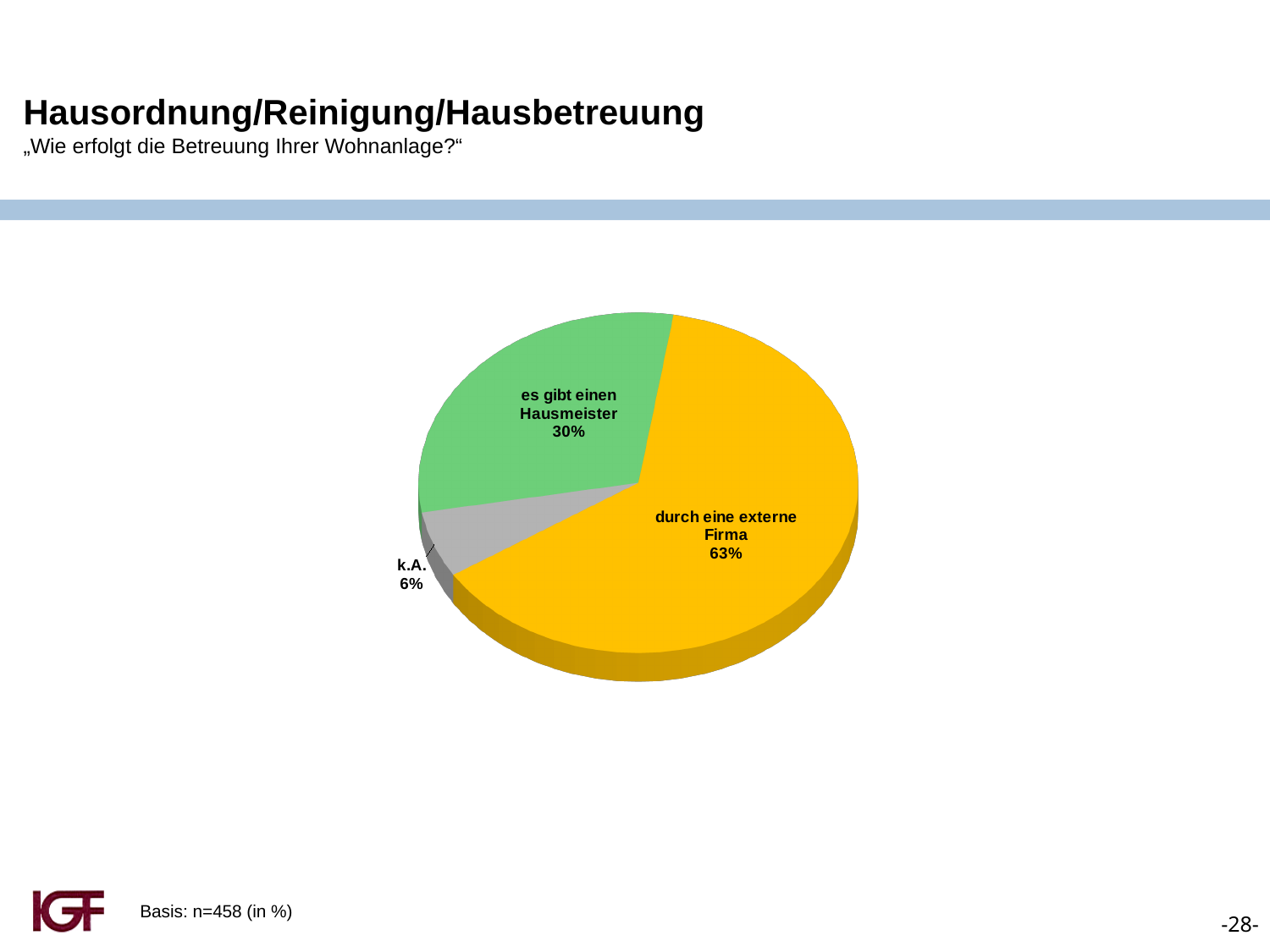
What share of respondents answered "k.A."? 6% How many slices does the pie chart have? 3 What is the difference in percentage points between "es gibt einen Hausmeister" and "k.A."? 24 What is the survey question shown under the slide title? „Wie erfolgt die Betreuung Ihrer Wohnanlage?“ What is the difference in percentage points between "durch eine externe Firma" and "es gibt einen Hausmeister"? 33 What colour is the slice for "durch eine externe Firma"? yellow What share of respondents answered "durch eine externe Firma"? 63% What share of respondents answered "es gibt einen Hausmeister"? 30% Which category has the largest share of the pie? durch eine externe Firma Which category has the smallest share of the pie? k.A. What kind of chart is shown on the slide? pie chart Which is larger: the share for "es gibt einen Hausmeister" or the share for "k.A."? es gibt einen Hausmeister